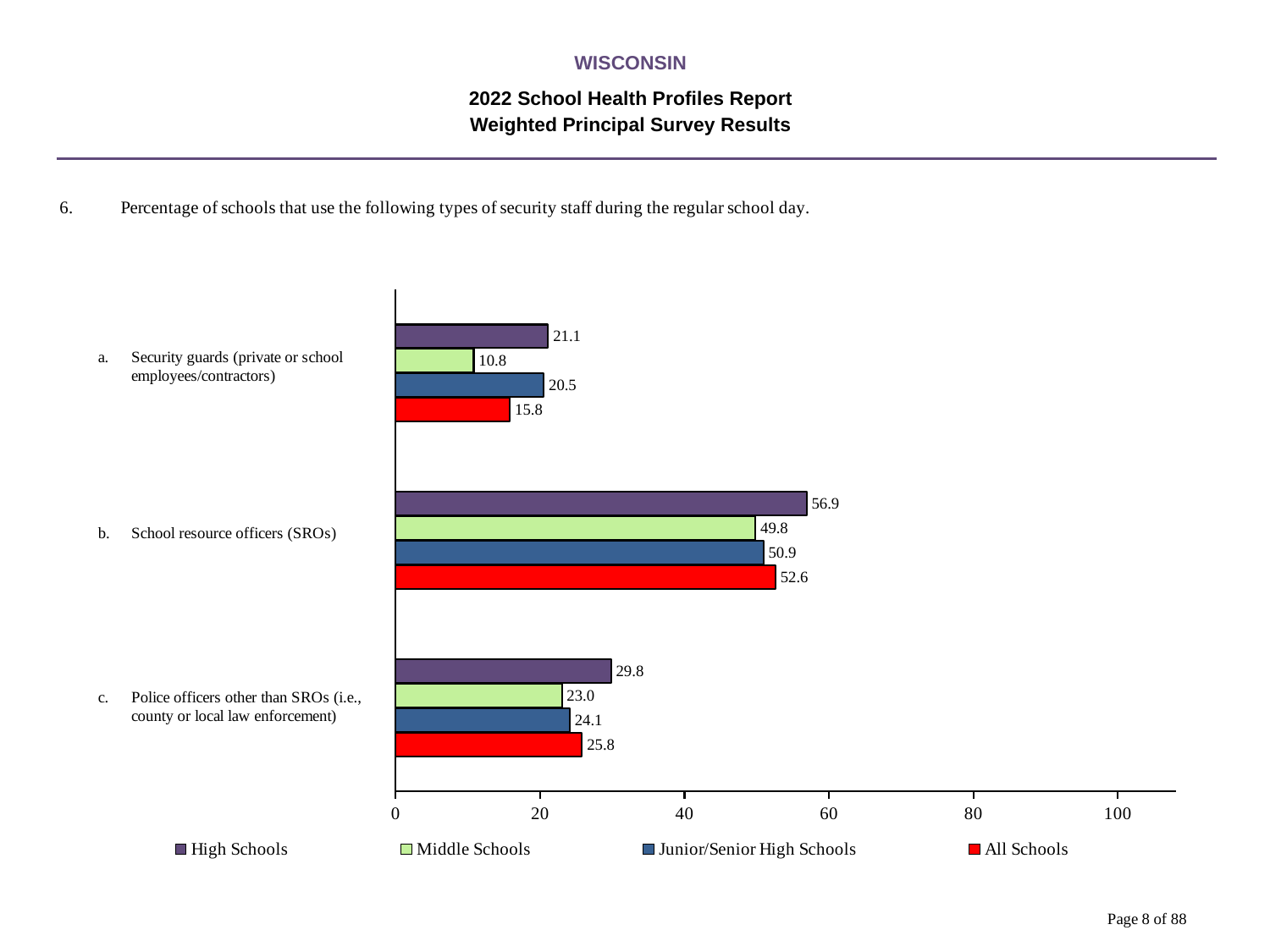
What is the difference between the High Schools and Middle Schools values for Police officers other than SROs? 6.8 What is the value for High Schools for School resource officers (SROs)? 56.9 Which school type has the highest value for Security guards? High Schools Is the value for High Schools for School resource officers (SROs) greater or less than 40? greater What is the value for Middle Schools for Security guards (private or school employees/contractors)? 10.8 What is the value for All Schools for Police officers other than SROs? 25.8 Which school type has the lowest value for School resource officers (SROs)? Middle Schools How many categories of security staff are shown in the chart? 3 What kind of chart is shown on the slide? Bar chart How many series does the legend list? 4 Which is larger for All Schools: the value for Security guards or the value for Police officers other than SROs? Police officers other than SROs What is the value for Junior/Senior High Schools for School resource officers (SROs)? 50.9